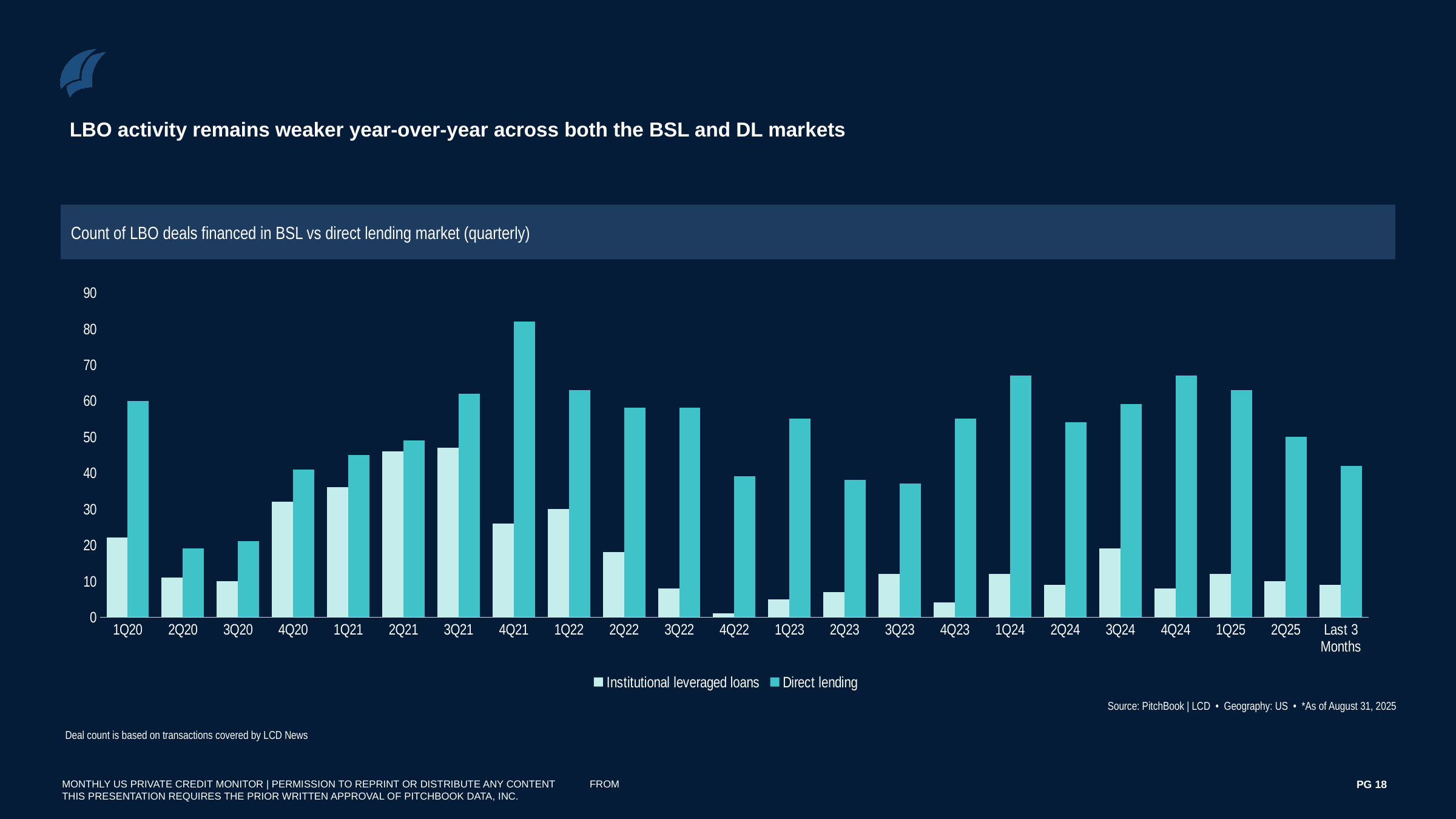
Is the Direct lending value for 4Q21 greater or less than 70? greater How many series does the legend list? 2 What kind of chart is shown on the slide? bar chart In which quarter is the Direct lending bar highest? 4Q21 In which quarter is the Institutional leveraged loans bar lowest? 4Q22 Is the Direct lending value for 2Q20 greater or less than 30? less Do the Institutional leveraged loans values rise or fall from 3Q21 to 4Q22? fall Is the Direct lending value for 1Q24 greater or less than 60? greater How many categories are shown on the x axis? 23 Which quarter has the larger Institutional leveraged loans value, 3Q24 or 4Q24? 3Q24 In 3Q21, which is larger: Institutional leveraged loans or Direct lending? Direct lending